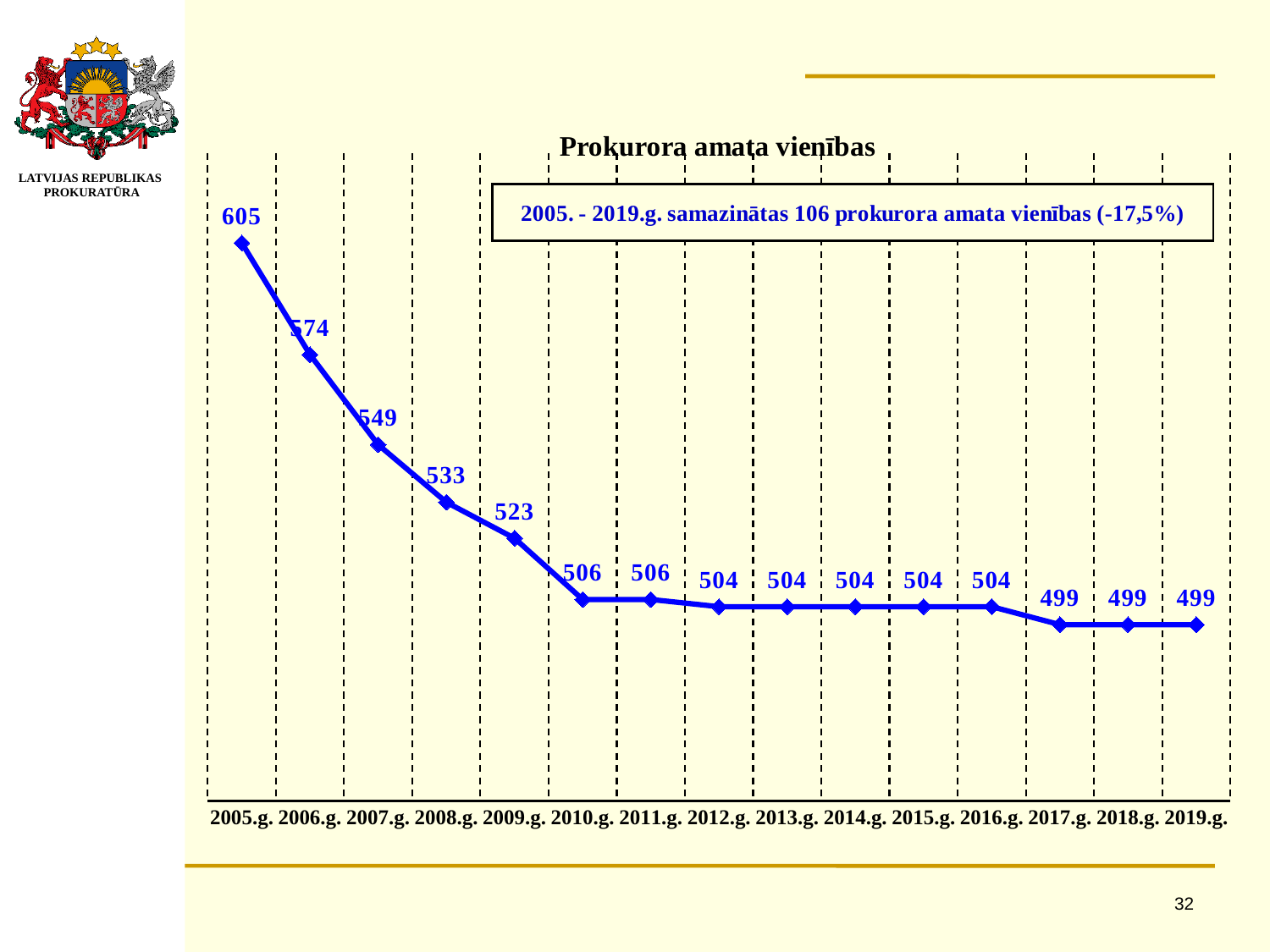
Do the values rise or fall from 2005.g. to 2019.g.? fall Which is larger, the value for 2008.g. or the value for 2010.g.? 2008.g. What is the difference between the values for 2005.g. and 2006.g.? 31 What is the value for 2019.g.? 499 What is the value for 2013.g.? 504 What kind of chart is this? line chart What is the value for 2009.g.? 523 Which year has the highest value? 2005.g. What is the difference between the values for 2005.g. and 2019.g.? 106 How many years are plotted on the x axis? 15 What is the value for 2005.g.? 605 What is the title of the chart? Prokurora amata vienības